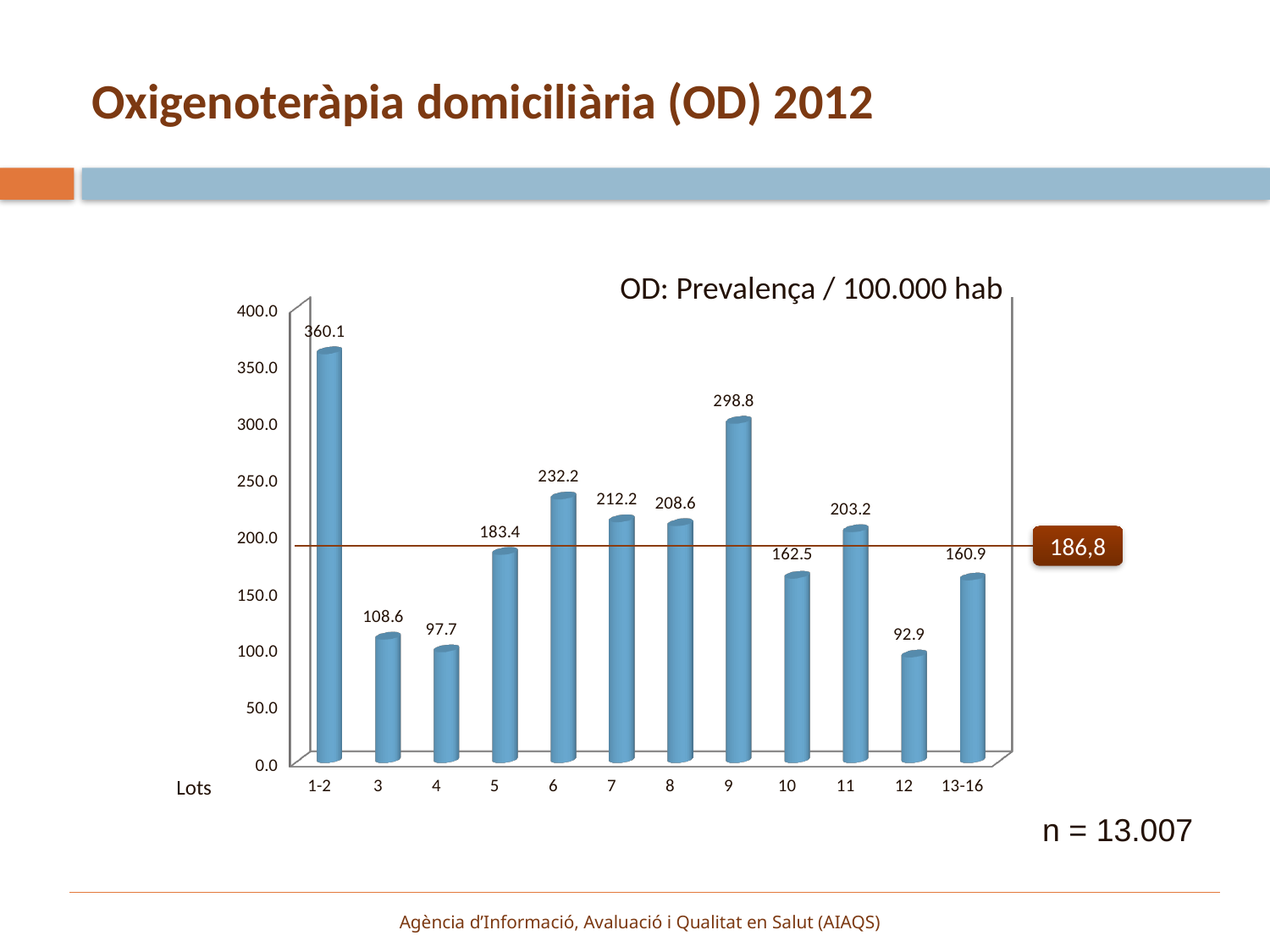
What is the value for lot 5? 183.4 Is the value for lot 10 greater or less than 150.0? greater What is the difference between the values for lot 1-2 and lot 9? 61.3 What is the difference between the values for lot 3 and lot 4? 10.9 Which lot has the highest value? 1-2 What kind of chart is shown? Bar chart Which lot has the lowest value? 12 Which is larger, the value for lot 6 or the value for lot 11? Lot 6 How many lot categories are shown on the x axis? 12 What is the title of the chart? OD: Prevalença / 100.000 hab What is the value shown on the horizontal reference line? 186,8 What is the value for lot 9? 298.8